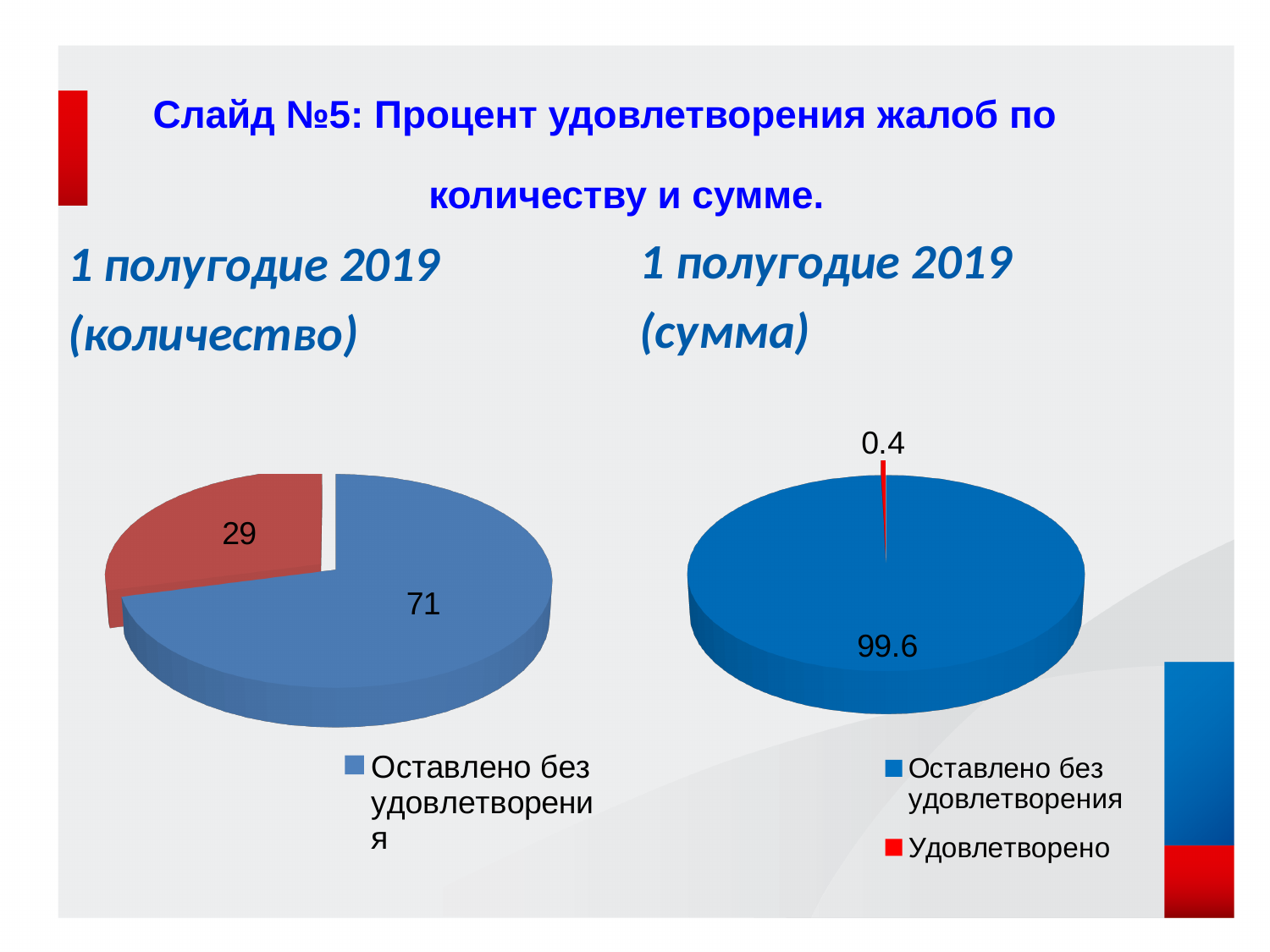
In the right chart '1 полугодие 2019 (сумма)', what colour represents 'Удовлетворено' in the legend? red In the left chart '1 полугодие 2019 (количество)', which slice is the largest? Оставлено без удовлетворения In the right chart '1 полугодие 2019 (сумма)', what value is shown for 'Удовлетворено'? 0.4 In the right chart '1 полугодие 2019 (сумма)', which category has the smallest slice? Удовлетворено In the right chart '1 полугодие 2019 (сумма)', what value is shown for 'Оставлено без удовлетворения'? 99.6 In the right chart '1 полугодие 2019 (сумма)', what is the difference between 'Оставлено без удовлетворения' and 'Удовлетворено'? 99.2 What kind of chart is the left chart titled '1 полугодие 2019 (количество)'? pie chart How many entries does the legend of the left chart '1 полугодие 2019 (количество)' list? 1 How many slices does the left chart '1 полугодие 2019 (количество)' have? 2 In the left chart '1 полугодие 2019 (количество)', what is the difference between the blue slice value and the red slice value? 42 In the left chart '1 полугодие 2019 (количество)', what value is shown for 'Оставлено без удовлетворения'? 71 In the left chart '1 полугодие 2019 (количество)', what value is shown on the red slice? 29